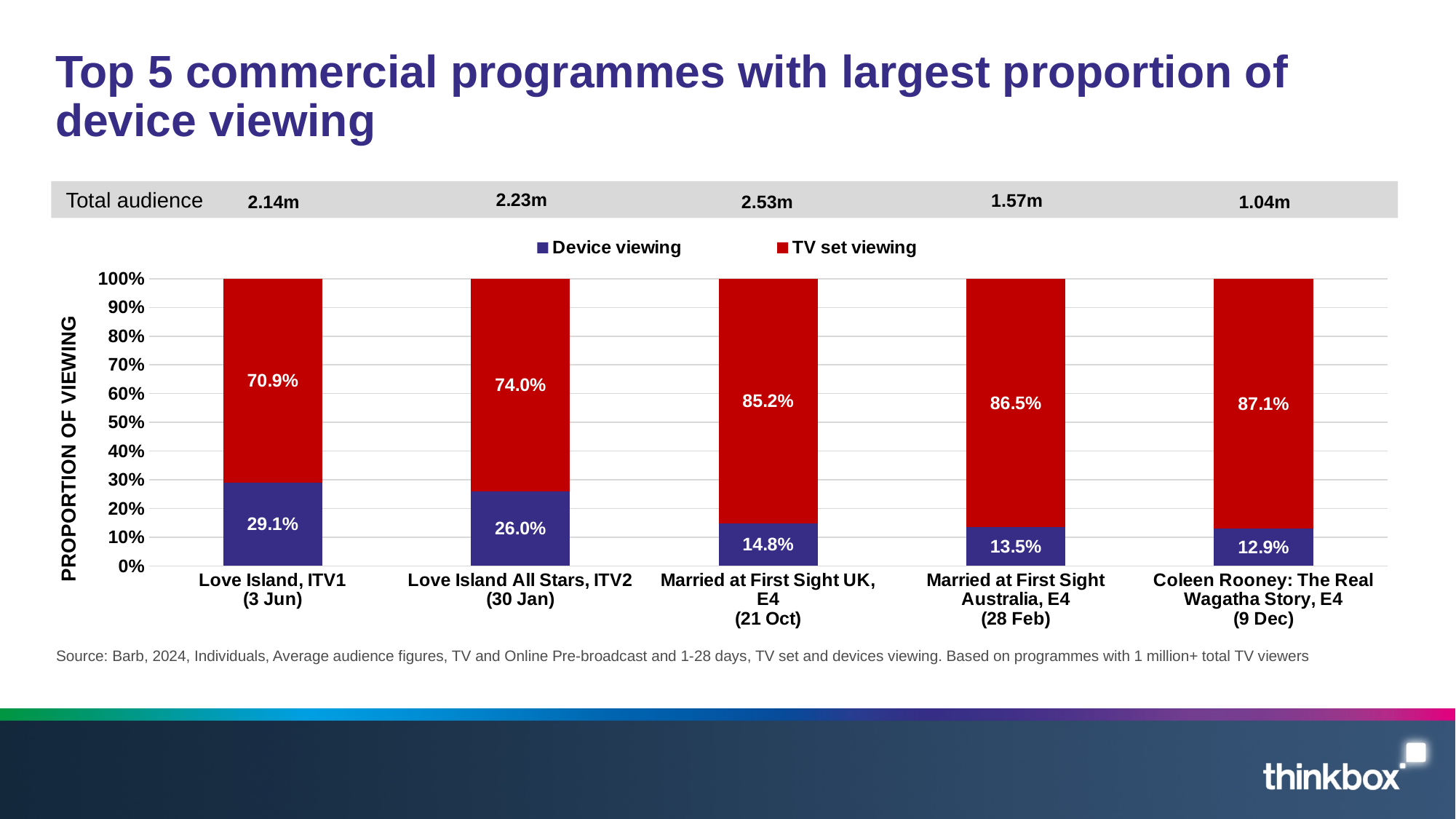
Which programme has the lowest TV set viewing proportion? Love Island, ITV1 (3 Jun) What is the total audience shown for Married at First Sight UK, E4 (21 Oct)? 2.53m How many programmes are shown on the chart? 5 Which has a larger Device viewing proportion: Married at First Sight UK, E4 (21 Oct) or Married at First Sight Australia, E4 (28 Feb)? Married at First Sight UK, E4 (21 Oct) Does the Device viewing proportion rise or fall from left to right across the programmes? Fall How many series does the legend list? 2 What kind of chart is shown on the slide? Stacked bar chart What is the TV set viewing value for Married at First Sight Australia, E4 (28 Feb)? 86.5% What is the Device viewing value for Love Island, ITV1 (3 Jun)? 29.1% What is the Device viewing value for Coleen Rooney: The Real Wagatha Story, E4 (9 Dec)? 12.9% What is the difference between the Device viewing values for Love Island, ITV1 (3 Jun) and Love Island All Stars, ITV2 (30 Jan)? 3.1% Which programme has the highest Device viewing proportion? Love Island, ITV1 (3 Jun)